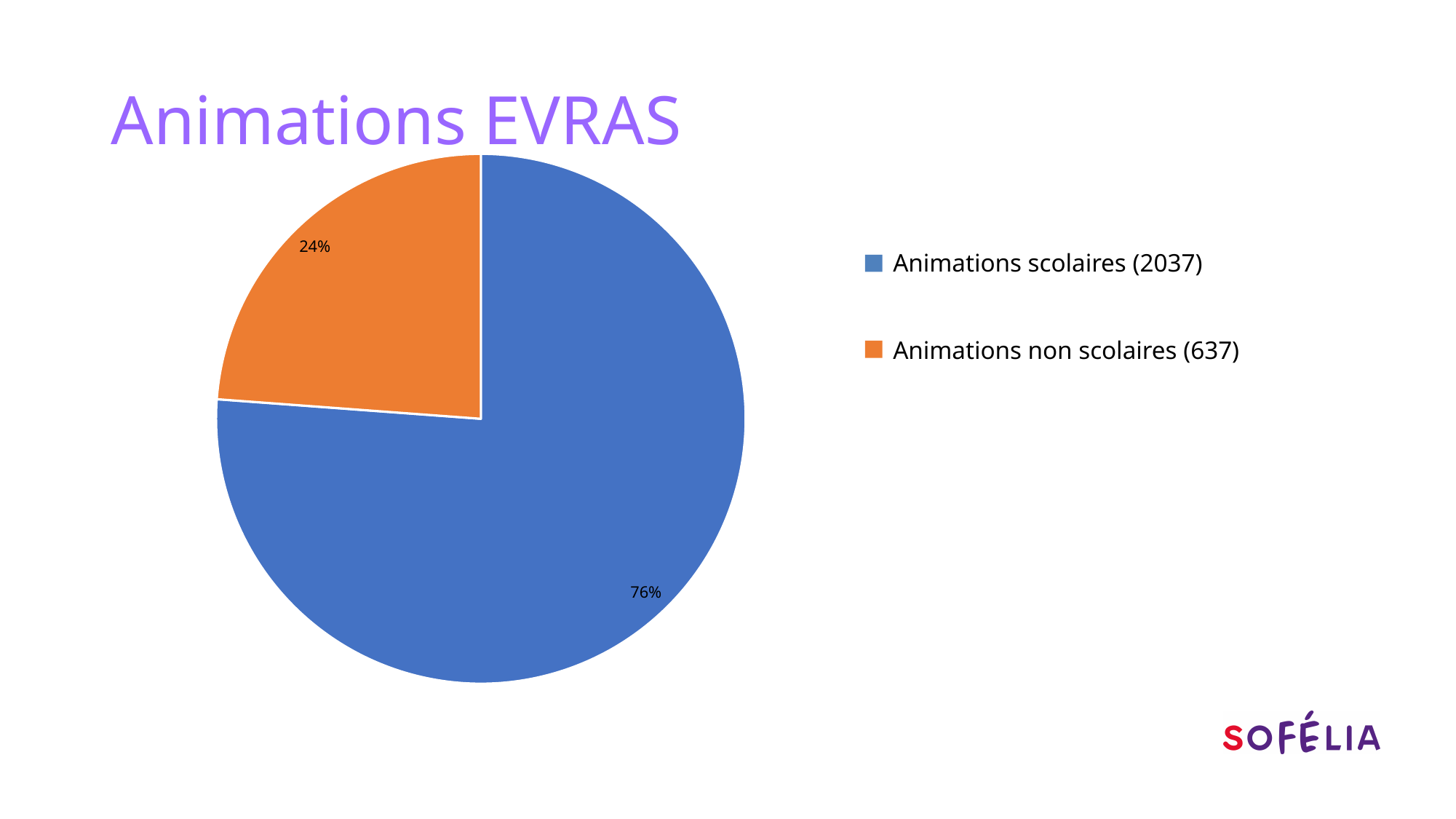
What type of chart is shown on the slide? pie chart What colour is the Animations non scolaires slice in the pie chart? orange How many slices does the pie chart have? 2 Which slice is larger: Animations scolaires or Animations non scolaires? Animations scolaires What is the title of the chart on the slide? Animations EVRAS What count is shown in the legend for Animations non scolaires? 637 What is the difference in percentage points between the Animations scolaires and Animations non scolaires slices? 52 What percentage share does Animations non scolaires have in the pie chart? 24% What count is shown in the legend for Animations scolaires? 2037 What percentage share does Animations scolaires have in the pie chart? 76% Which category has the smallest slice of the pie chart? Animations non scolaires Which category has the largest slice of the pie chart? Animations scolaires